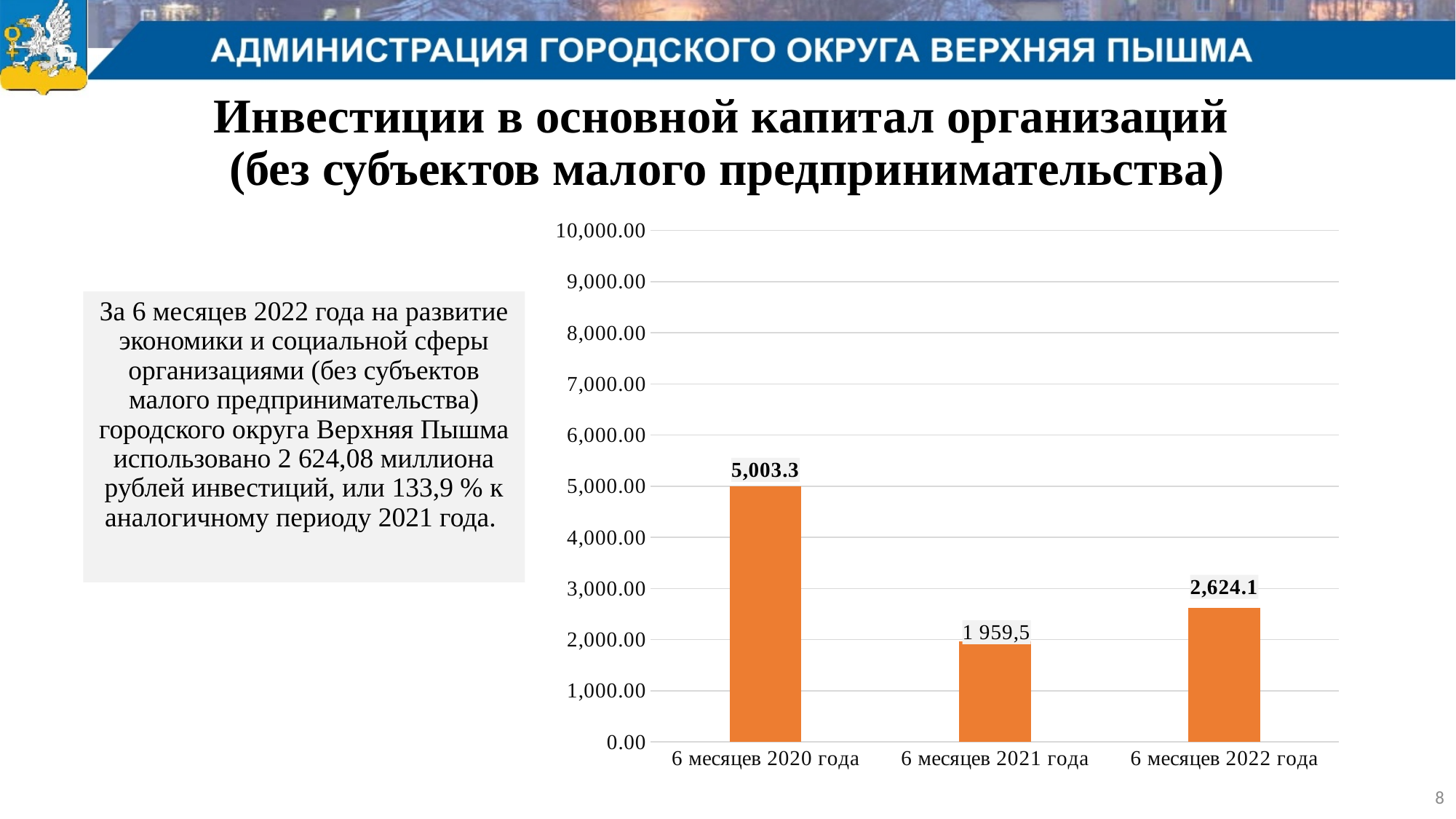
Does the value rise or fall from 6 месяцев 2021 года to 6 месяцев 2022 года? rise What is the difference between the values for 6 месяцев 2022 года and 6 месяцев 2021 года? 664.6 What kind of chart is shown on the slide? bar chart Which period has the highest value? 6 месяцев 2020 года What is the value for 6 месяцев 2021 года? 1 959,5 What is the value for 6 месяцев 2022 года? 2,624.1 How many bars are shown in the chart? 3 What is the difference between the values for 6 месяцев 2020 года and 6 месяцев 2021 года? 3,043.8 Which is larger, the value for 6 месяцев 2022 года or 6 месяцев 2021 года? 6 месяцев 2022 года What is the value for 6 месяцев 2020 года? 5,003.3 Is the value for 6 месяцев 2020 года greater or less than 4,000.00? greater Which period has the lowest value? 6 месяцев 2021 года